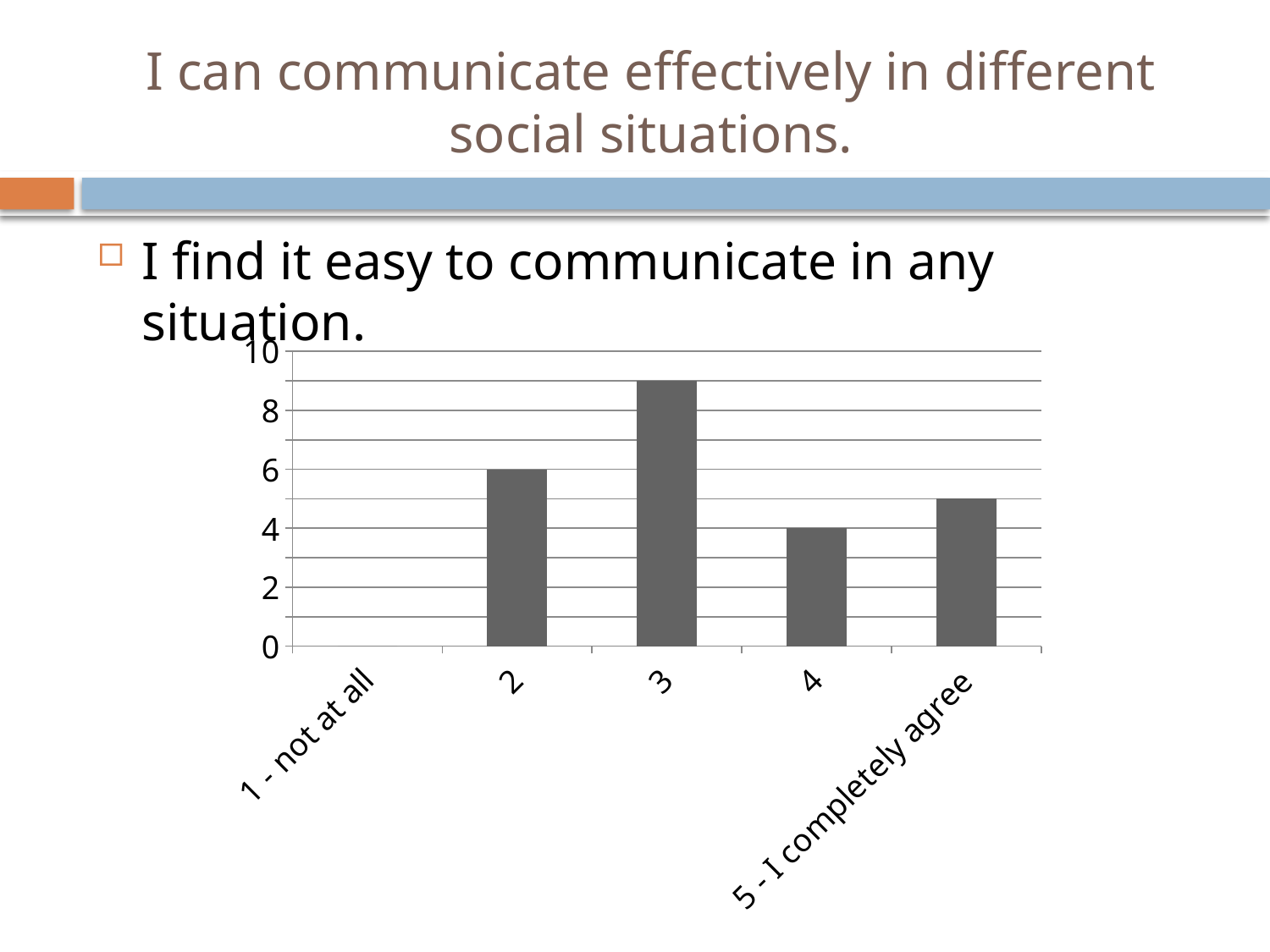
Is the value for '5 - I completely agree' greater or less than 6? less What is the difference between the value for category 2 and the value for category 4? 2 What is the value for category 4? 4 How many categories are shown on the x axis of the chart? 5 What is the value for category 2? 6 Which category has the lowest value? 1 - not at all What is the highest value labelled on the vertical axis of the chart? 10 Is the value for category 3 greater or less than 8? greater Which category has the highest value? 3 What type of chart is shown on the slide? bar chart What is the value for the category '1 - not at all'? 0 Which is larger, the value for category 2 or the value for category 4? 2